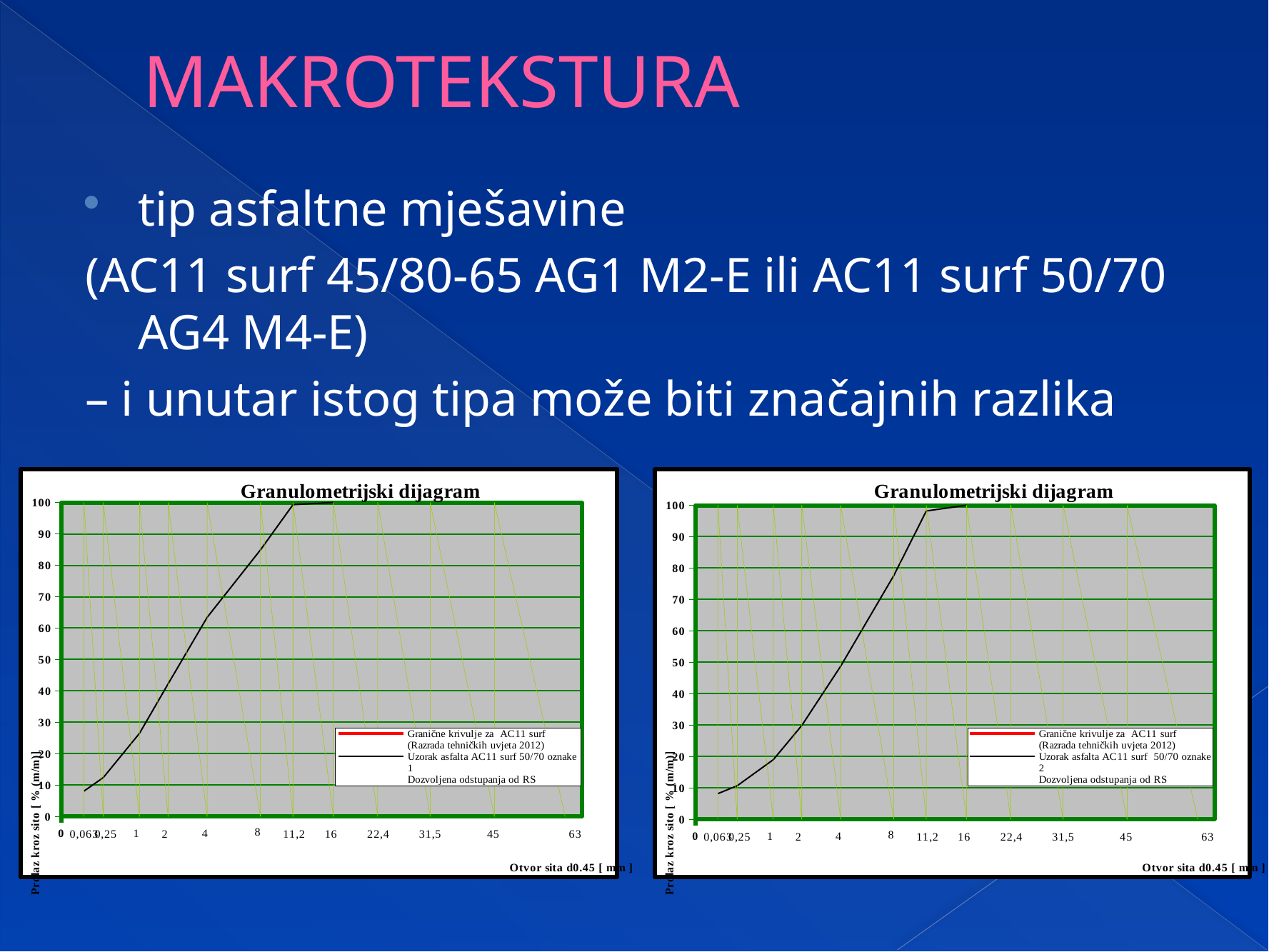
How many entries does the legend of the left chart list? 3 In the left chart, is the value of the curve at sieve opening 1 greater or less than 20? greater In the right chart, is the value of the curve at sieve opening 4 greater or less than 40? greater In the right chart, does the plotted curve rise or fall along the x axis? rise In the right chart, is the value of the curve at sieve opening 11,2 greater or less than 90? greater What is the x-axis label of the left chart? Otvor sita d0.45 [ mm ] What is the title of the right chart? Granulometrijski dijagram In the left chart, does the plotted curve rise or fall as the sieve opening increases along the x axis? rise What type of chart is the left chart titled 'Granulometrijski dijagram'? line chart At sieve opening 4, which chart shows the higher value on its curve, the left chart or the right chart? left chart